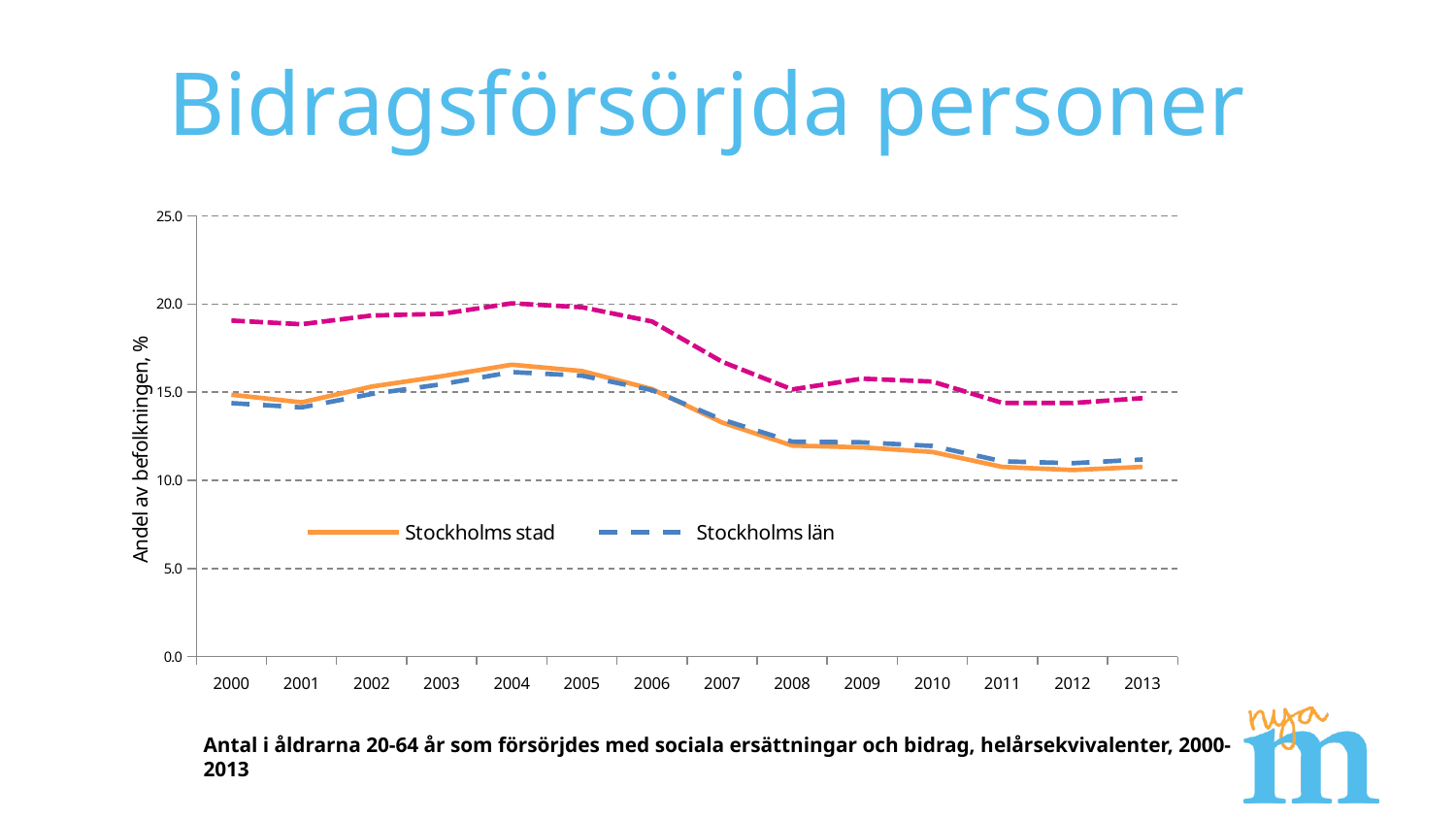
In 2000, which is higher: Stockholms stad or Stockholms län? Stockholms stad How many years are plotted along the x axis? 14 What colour is the line for Stockholms stad? orange How many series does the chart's legend list? 2 Is the value for Stockholms län in 2008 greater or less than 10? greater What kind of chart is shown on the slide? line chart Is the value for Stockholms stad in 2004 greater or less than 15? greater Is the value for Stockholms stad in 2013 greater or less than 15? less Does the Stockholms stad line rise or fall from 2004 to 2013? fall In 2013, which is higher: Stockholms stad or Stockholms län? Stockholms län What is the label of the y axis? Andel av befolkningen, %